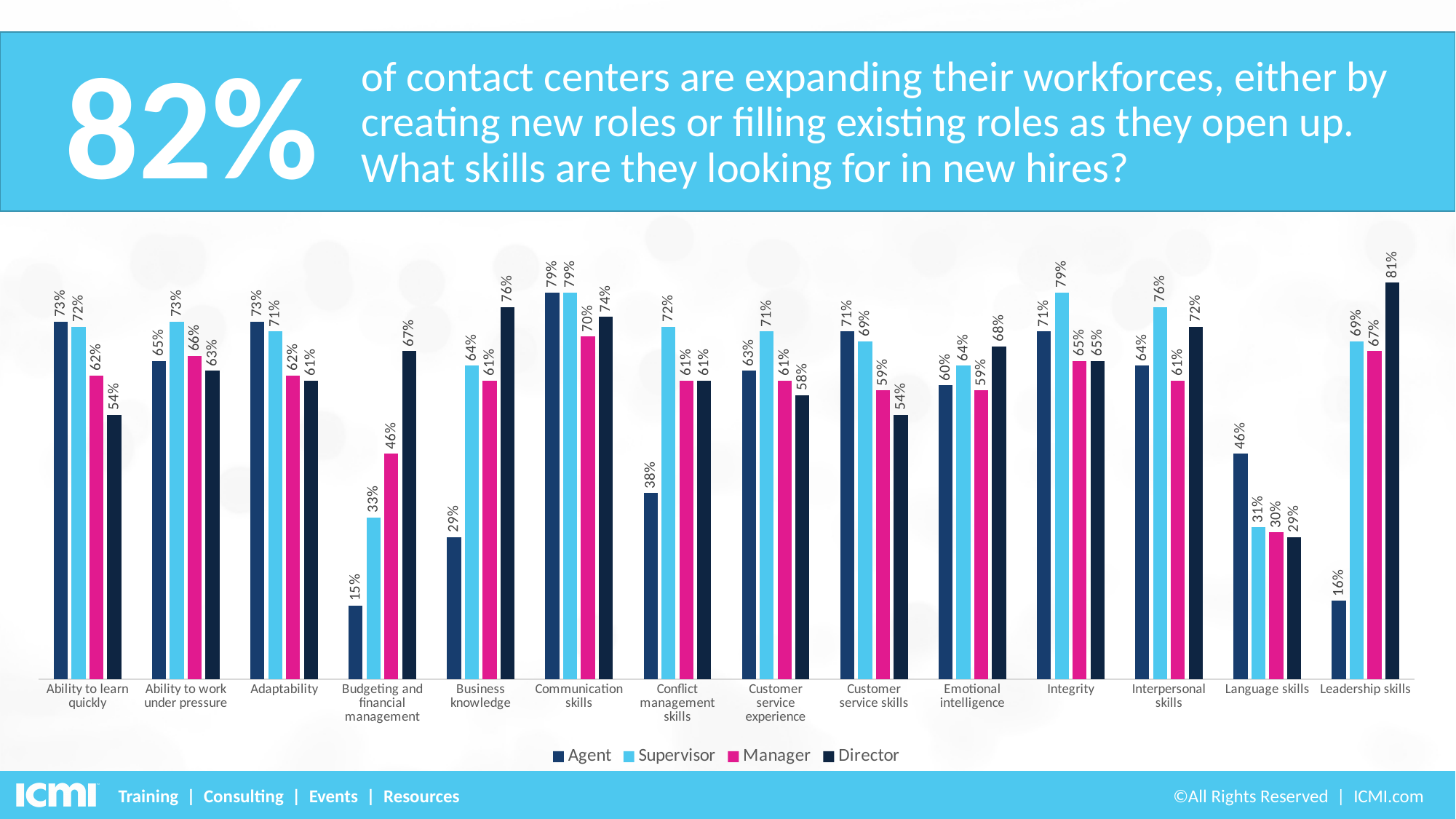
Which skill has the highest Director value? Leadership skills What is the Supervisor value for Conflict management skills? 72% How many series does the legend list? 4 Which skill has the lowest Agent value? Budgeting and financial management What is the Agent value for Budgeting and financial management? 15% Which series is shown in pink in the legend? Manager What kind of chart is shown on the slide? Bar chart What is the Director value for Leadership skills? 81% For Language skills, which is larger: the Agent value or the Supervisor value? Agent What is the Manager value for Customer service skills? 59% How many skill categories are shown on the x axis? 14 What is the difference between the Director and Agent values for Leadership skills? 65%